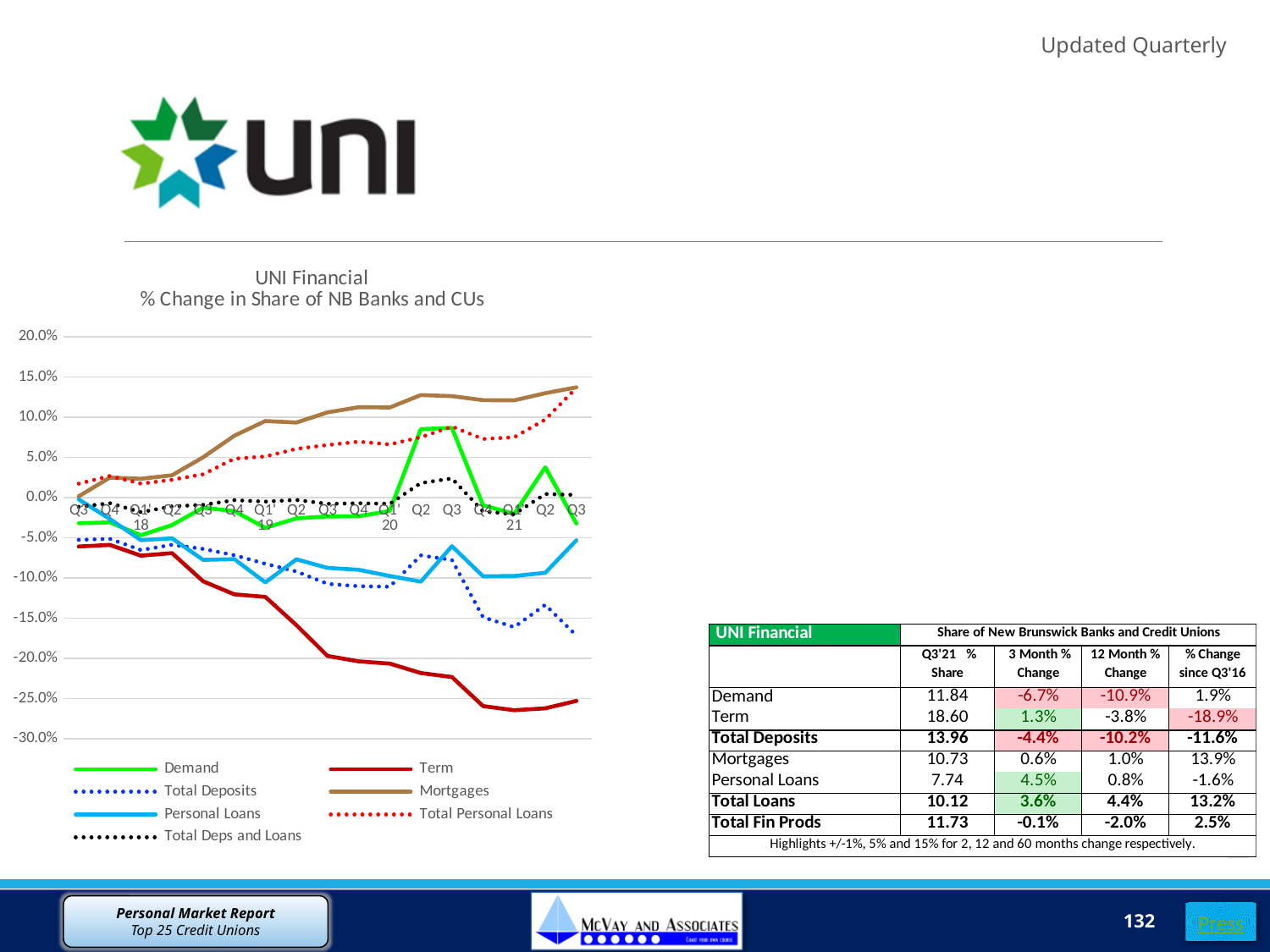
Which series is the lowest at the last point (Q3 '21) on the chart? Term Is the value for Term at Q3 '21 greater or less than -20.0%? less Is the value for Demand at Q2 '20 greater or less than 5.0%? greater How many series does the chart legend list? 7 Does the Mortgages series rise or fall along the x axis from Q3 '17 to Q3 '21? rise At Q3 '21, which is larger: the value for Demand or the value for Term? Demand What colour is the Demand line in the chart? green What is the title of the chart? UNI Financial % Change in Share of NB Banks and CUs What kind of chart is shown on the slide? line chart Is the value for Mortgages at Q3 '21 greater or less than 10.0%? greater Does the Term series rise or fall along the x axis from Q3 '17 to Q3 '21? fall